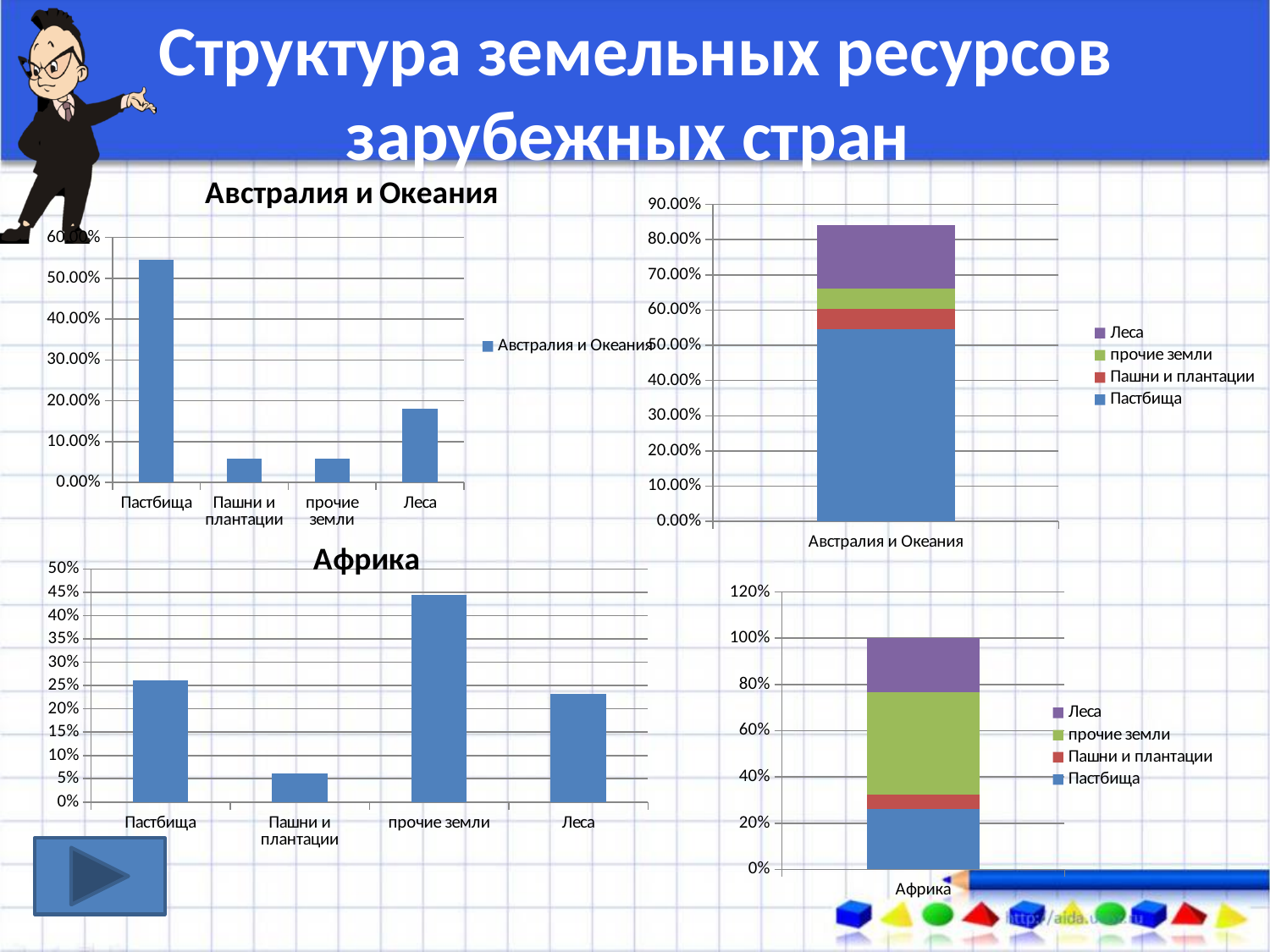
In the stacked chart on the bottom right (Африка), which colour represents Леса in the legend? purple How many categories are shown on the x axis of the chart titled "Австралия и Океания" (top left)? 4 In the chart titled "Австралия и Океания" (top left), is the value for Пастбища greater or less than 50.00%? greater In the chart titled "Африка" (bottom left), is the value for Пашни и плантации greater or less than 10%? less In the chart titled "Австралия и Океания" (top left), which category has the highest value? Пастбища In the chart titled "Австралия и Океания" (top left), is the value for Леса greater or less than 20.00%? less In the chart titled "Африка" (bottom left), which category has the highest value? прочие земли In the chart titled "Африка" (bottom left), which category has the lowest value? Пашни и плантации In the chart titled "Австралия и Океания" (top left), which is larger: the value for Леса or the value for Пашни и плантации? Леса What kind of chart is the chart titled "Африка" (bottom left)? bar chart How many series does the legend list in the stacked chart on the top right (Австралия и Океания)? 4